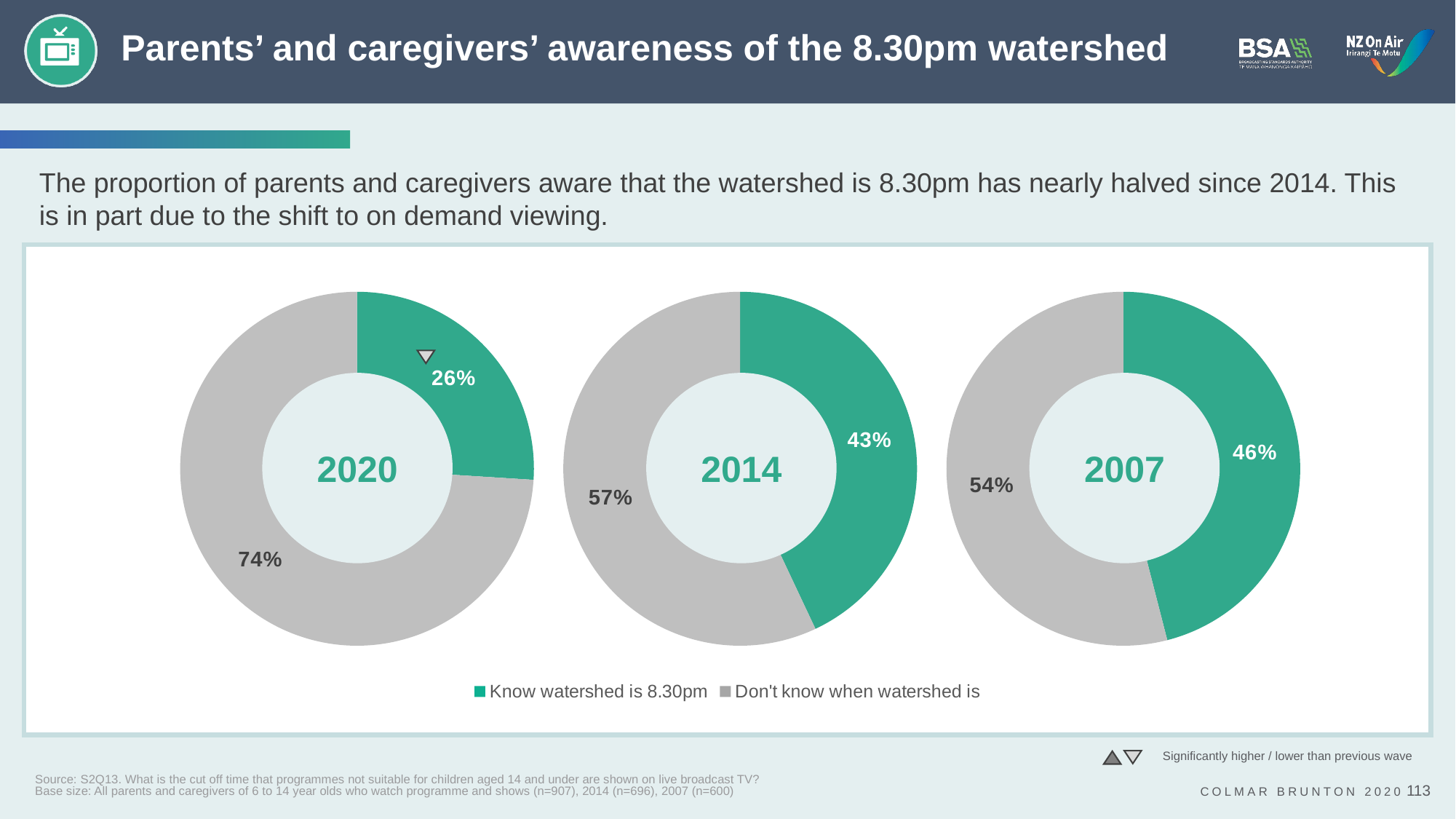
Which colour represents 'Know watershed is 8.30pm' in the legend? Green Across the three charts, which year has the lowest share of parents who know the watershed is 8.30pm? 2020 What is the difference between the 'Know watershed is 8.30pm' share in 2014 and in 2020? 17 percentage points Across the three charts, which year has the highest share of parents who know the watershed is 8.30pm? 2007 In the 2020 chart, what percentage don't know when the watershed is? 74% How many series does the legend list? 2 In the 2007 chart, what percentage know the watershed is 8.30pm? 46% How many charts are shown on the slide? 3 What kind of chart is used to show the data for each year? Doughnut (pie) chart In the 2014 chart, what percentage don't know when the watershed is? 57% In the 2020 chart, what percentage of parents and caregivers know the watershed is 8.30pm? 26% Is the 'Don't know when watershed is' share larger in the 2020 chart or the 2007 chart? 2020